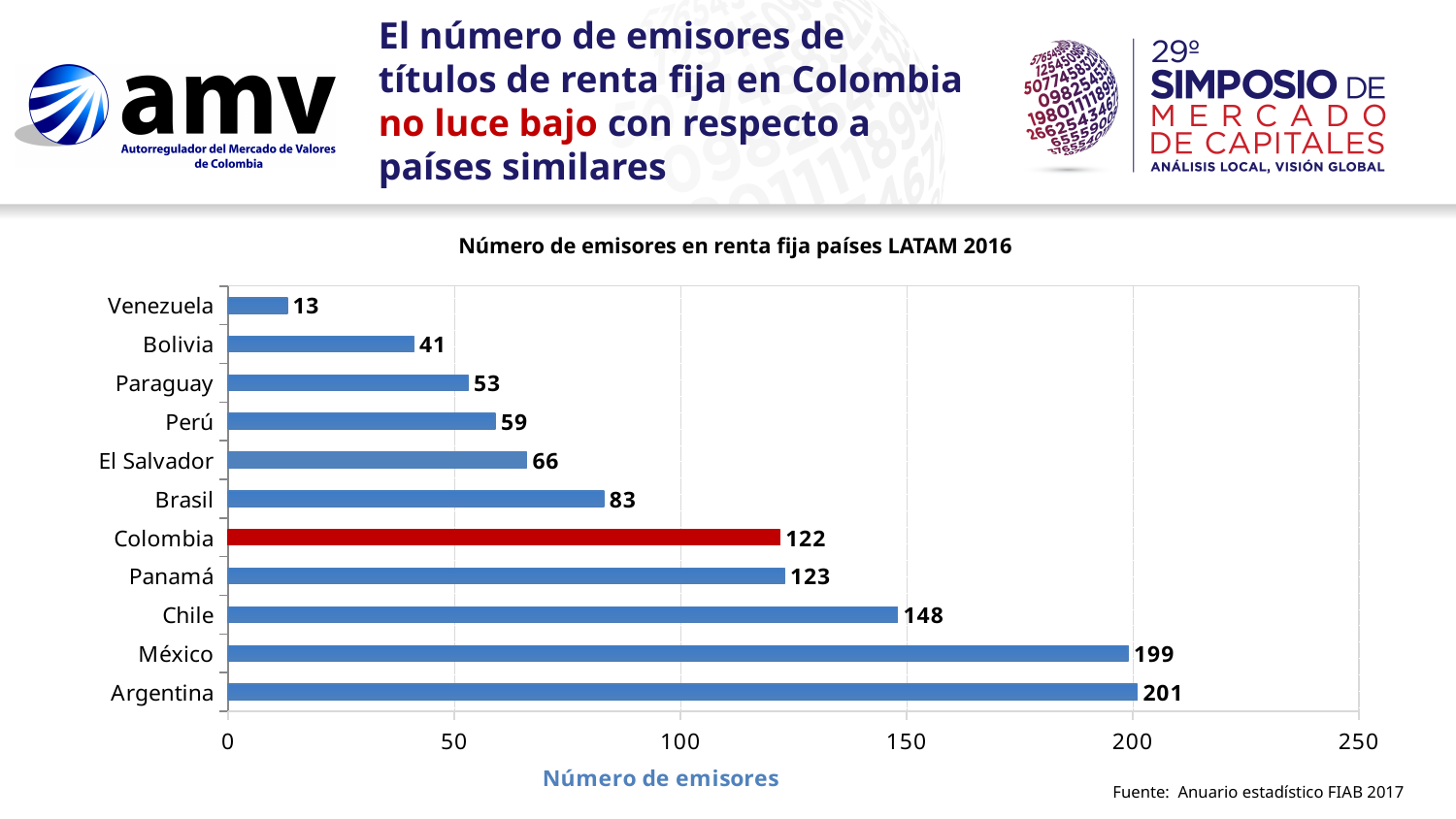
What is the difference between the number of emisores for México and Chile? 51 What is the title of the chart? Número de emisores en renta fija países LATAM 2016 What is the number of emisores for Colombia? 122 What is the difference between the number of emisores for Panamá and Colombia? 1 What is the number of emisores for Chile? 148 Which has more emisores, Brasil or Perú? Brasil What is the number of emisores for Venezuela? 13 Which country has the highest number of emisores? Argentina Which country has the lowest number of emisores? Venezuela What kind of chart is shown on the slide? Bar chart Which country's bar is coloured red in the chart? Colombia How many countries are shown in the chart? 11